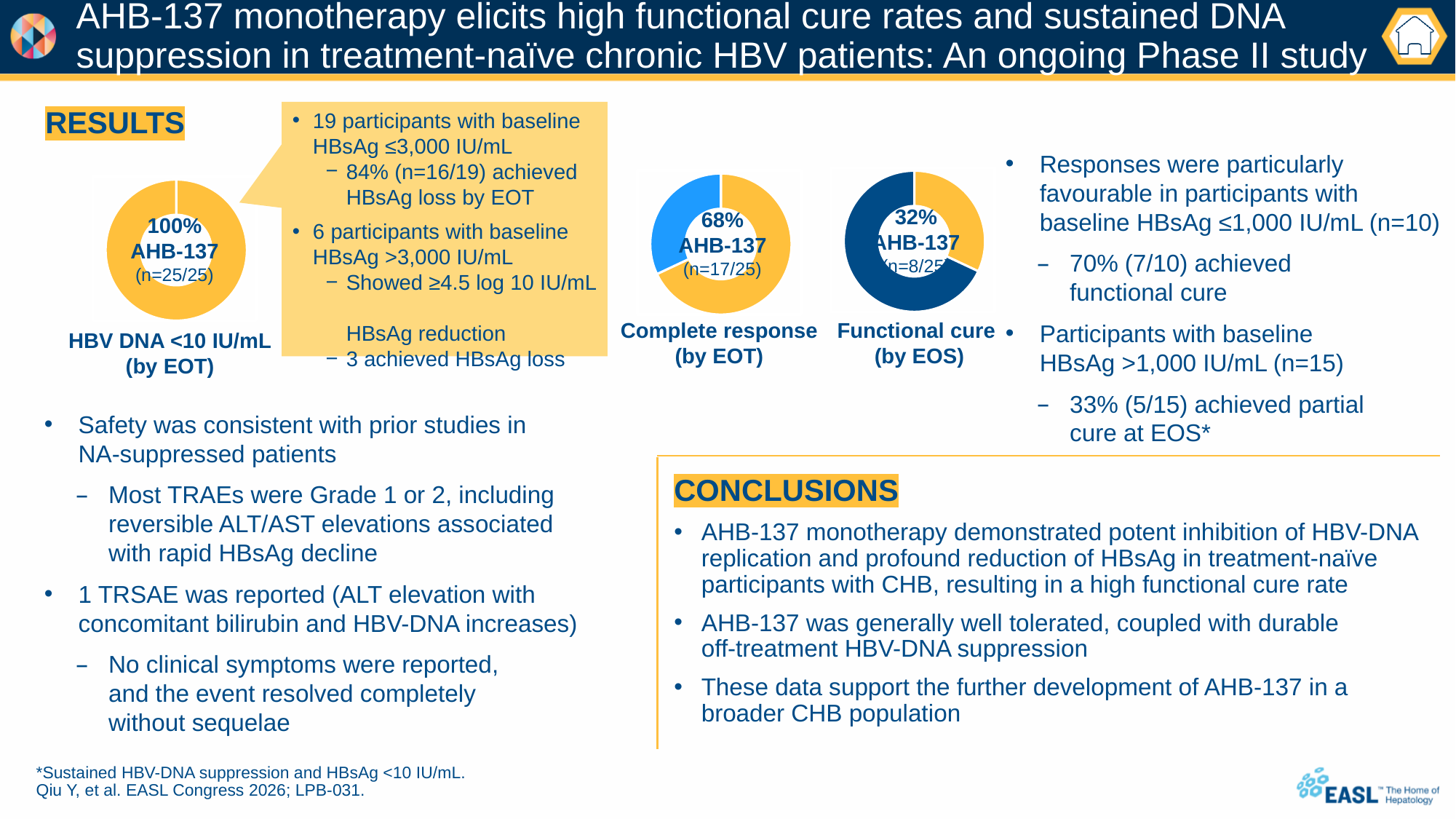
Which of the three donut charts shows the highest percentage? HBV DNA <10 IU/mL (by EOT) What percentage is shown in the 'HBV DNA <10 IU/mL (by EOT)' donut chart? 100% In the 'Complete response (by EOT)' chart, how many participants out of 25 achieved complete response? n=17/25 Which is larger: the percentage in the 'Complete response (by EOT)' chart or the percentage in the 'Functional cure (by EOS)' chart? Complete response (by EOT) What type of chart is used to show the 'Complete response (by EOT)' result? Donut (pie) chart What drug name is labelled inside each of the donut charts? AHB-137 What percentage is shown in the 'Complete response (by EOT)' donut chart? 68% What is the difference in percentage points between the 'Complete response (by EOT)' chart and the 'Functional cure (by EOS)' chart? 36 percentage points How many donut charts are shown on the slide? 3 Which of the three donut charts shows the lowest percentage? Functional cure (by EOS) What percentage is shown in the 'Functional cure (by EOS)' donut chart? 32% In the 'Functional cure (by EOS)' chart, how many participants out of 25 achieved functional cure? n=8/25